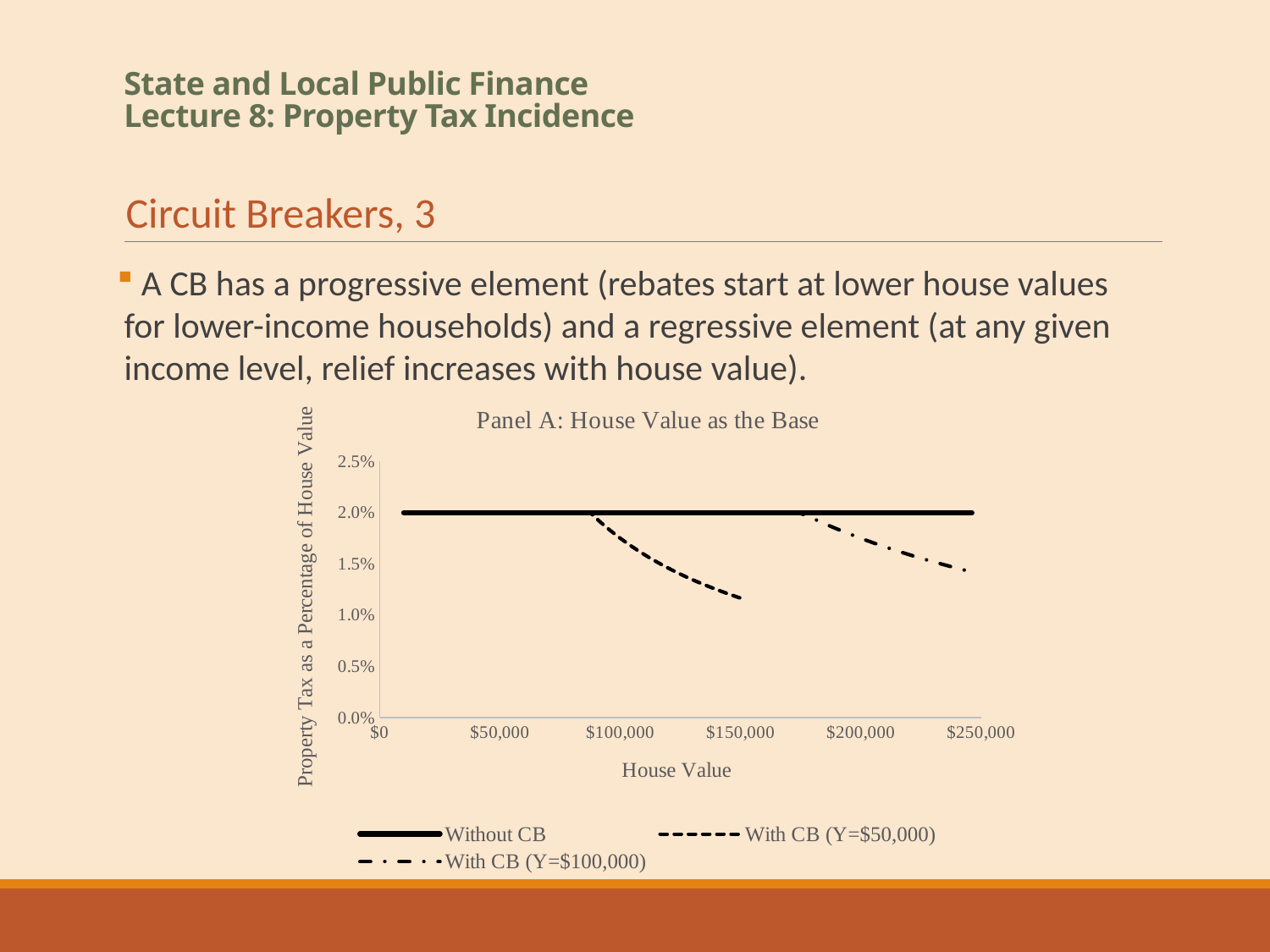
What is the label of the chart's x axis? House Value Does the 'With CB (Y=$100,000)' line rise or fall as house value increases? Fall At a house value of $150,000, is the value for 'With CB (Y=$50,000)' greater or less than 1.5%? less What property tax percentage does the 'Without CB' line sit at across all house values? 2.0% What kind of chart is shown on the slide? Line chart At a house value of $150,000, is the value for 'With CB (Y=$50,000)' greater or less than 1.0%? greater At a house value of $250,000, is the value for 'With CB (Y=$100,000)' greater or less than 1.0%? greater Does the 'With CB (Y=$50,000)' line rise or fall as house value increases? Fall How many series does the chart's legend list? 3 Does the 'Without CB' line rise, fall, or stay flat as house value increases? Stays flat At a house value of $150,000, which is higher: 'Without CB' or 'With CB (Y=$50,000)'? Without CB What is the title of the chart? Panel A: House Value as the Base